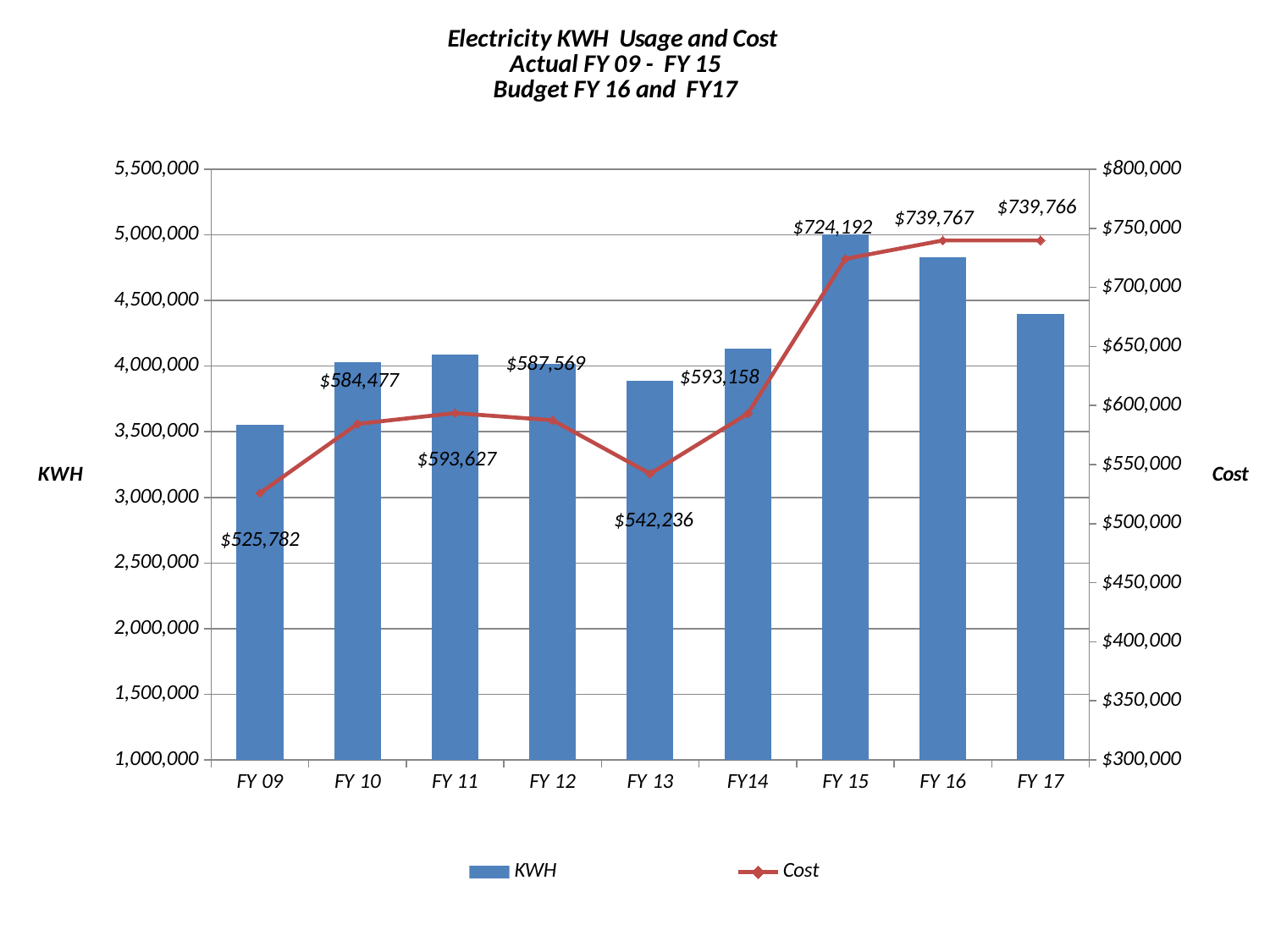
Which fiscal year has the lowest Cost? FY 09 What is the difference in Cost between FY 10 and FY 09? $58,695 What is the Cost value for FY 10? $584,477 How many series does the legend list? 2 What is the Cost value for FY 13? $542,236 What is the difference in Cost between FY 15 and FY14? $131,034 How many fiscal years are shown on the x axis? 9 Which fiscal year has the highest KWH bar? FY 15 Is the KWH value for FY 16 greater or less than 4,500,000? greater Which has the higher Cost, FY 11 or FY 12? FY 11 What is the Cost value for FY 15? $724,192 Is the KWH value for FY 09 greater or less than 4,000,000? less